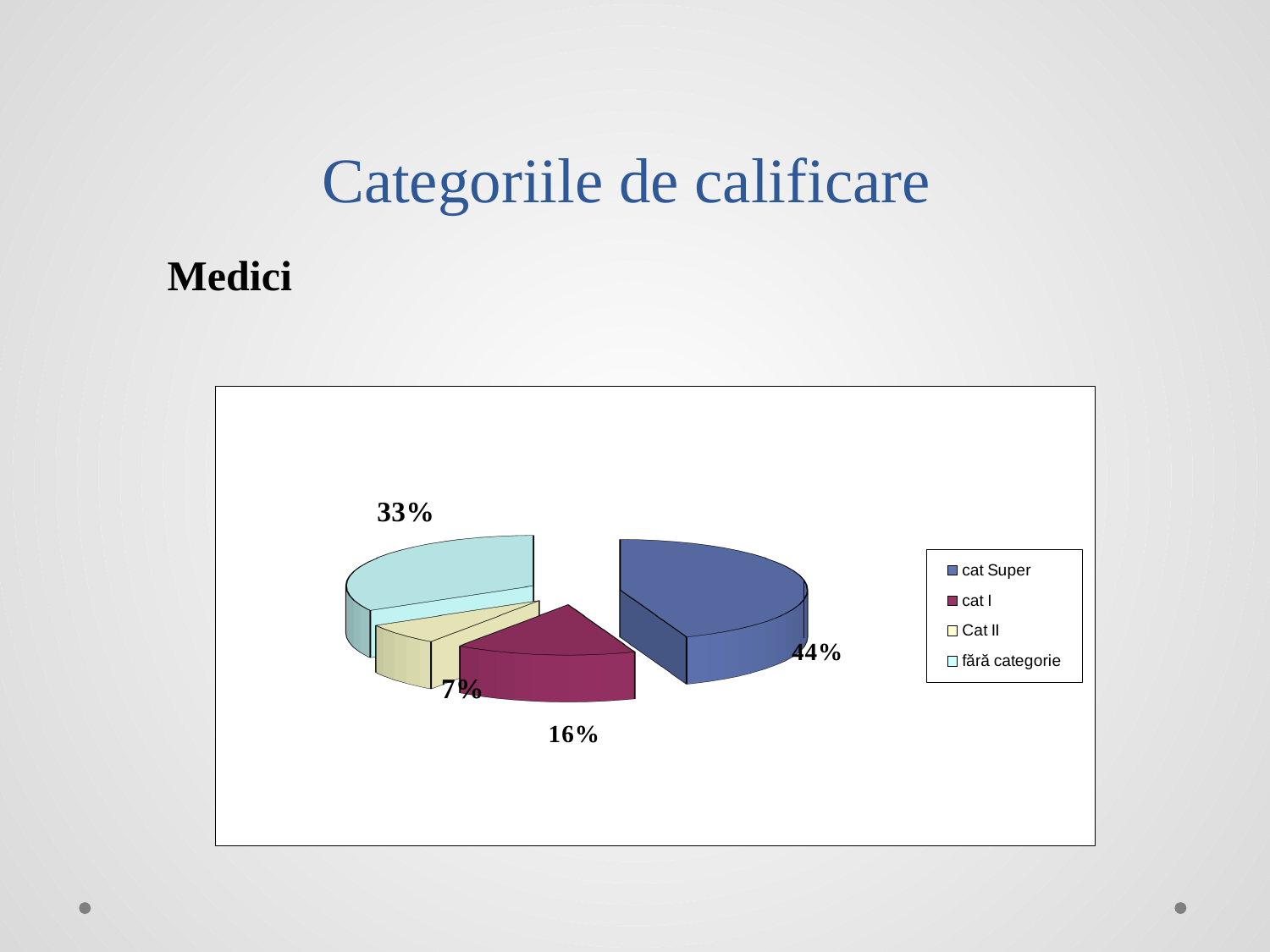
Which category has the largest slice of the pie? cat Super Which is larger, the share for cat I or the share for fără categorie? fără categorie What colour is the slice for cat I? dark red What share of the pie does cat I have? 16% How many categories are shown in the pie chart? 4 What share of the pie does fără categorie have? 33% What is the difference in percentage points between cat Super and fără categorie? 11 What share of the pie does cat Super have? 44% What is the difference in percentage points between cat I and Cat II? 9 Which category has the smallest slice of the pie? Cat II What kind of chart is shown on the slide? pie chart